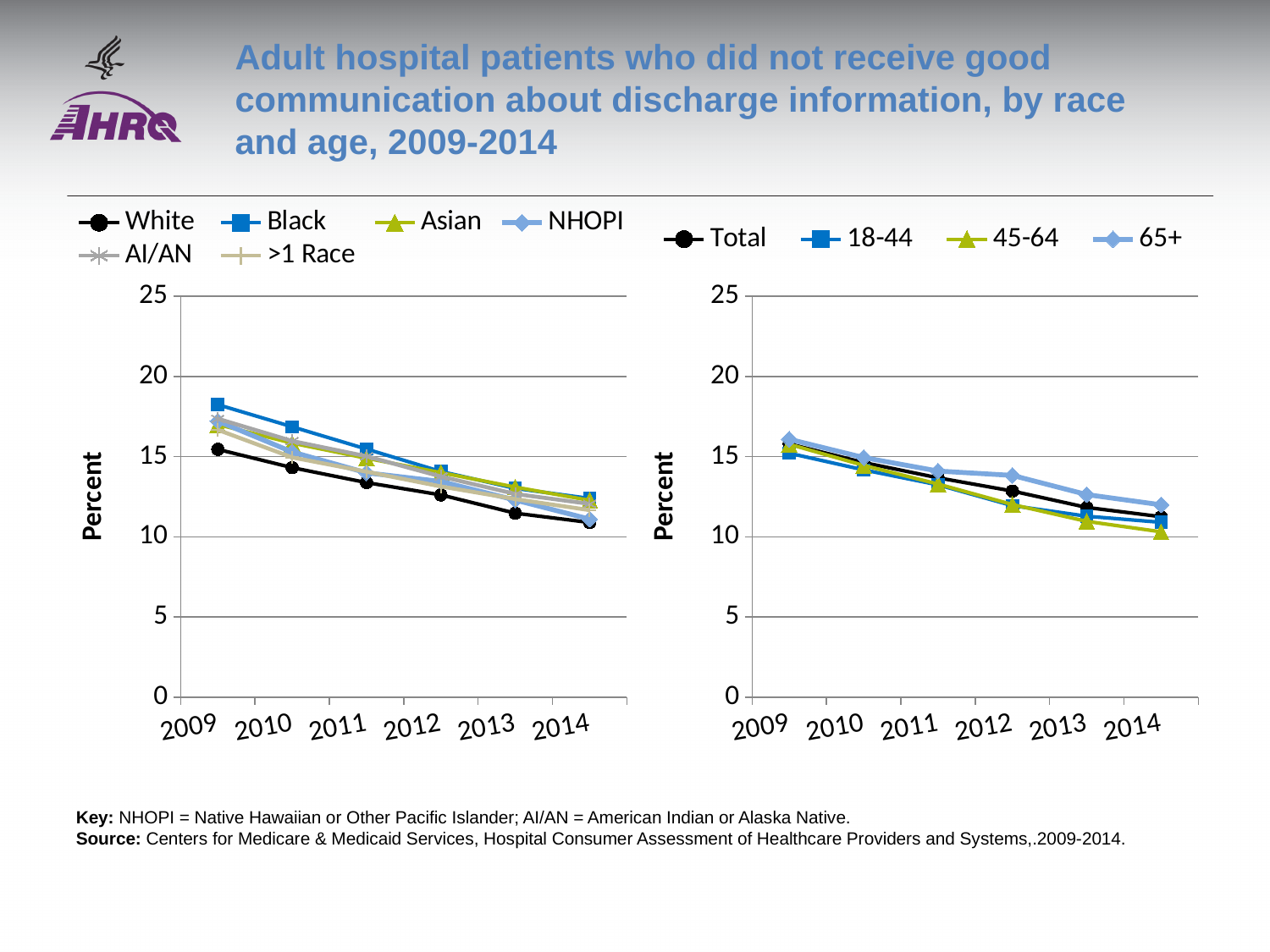
How many series does the legend of the right chart (by age) list? 4 In the left chart (by race), is the value for Black in 2009 greater or less than 15? greater In the left chart (by race), is the value for White in 2014 greater or less than 15? less In the left chart (by race), which group has the highest value in 2009? Black In the left chart (by race), which group has the lowest value in 2009? White In the right chart (by age), which is larger in 2014, the value for 65+ or the value for 45-64? 65+ In the right chart (by age), do the values for Total rise or fall from 2009 to 2014? fall How many years are plotted along the x axis of the right chart (by age)? 6 What type of chart is the left chart (by race)? line chart In the right chart (by age), which group has the highest value in 2014? 65+ In the right chart (by age), is the value for 65+ in 2009 greater or less than 15? greater How many series does the legend of the left chart (by race) list? 6